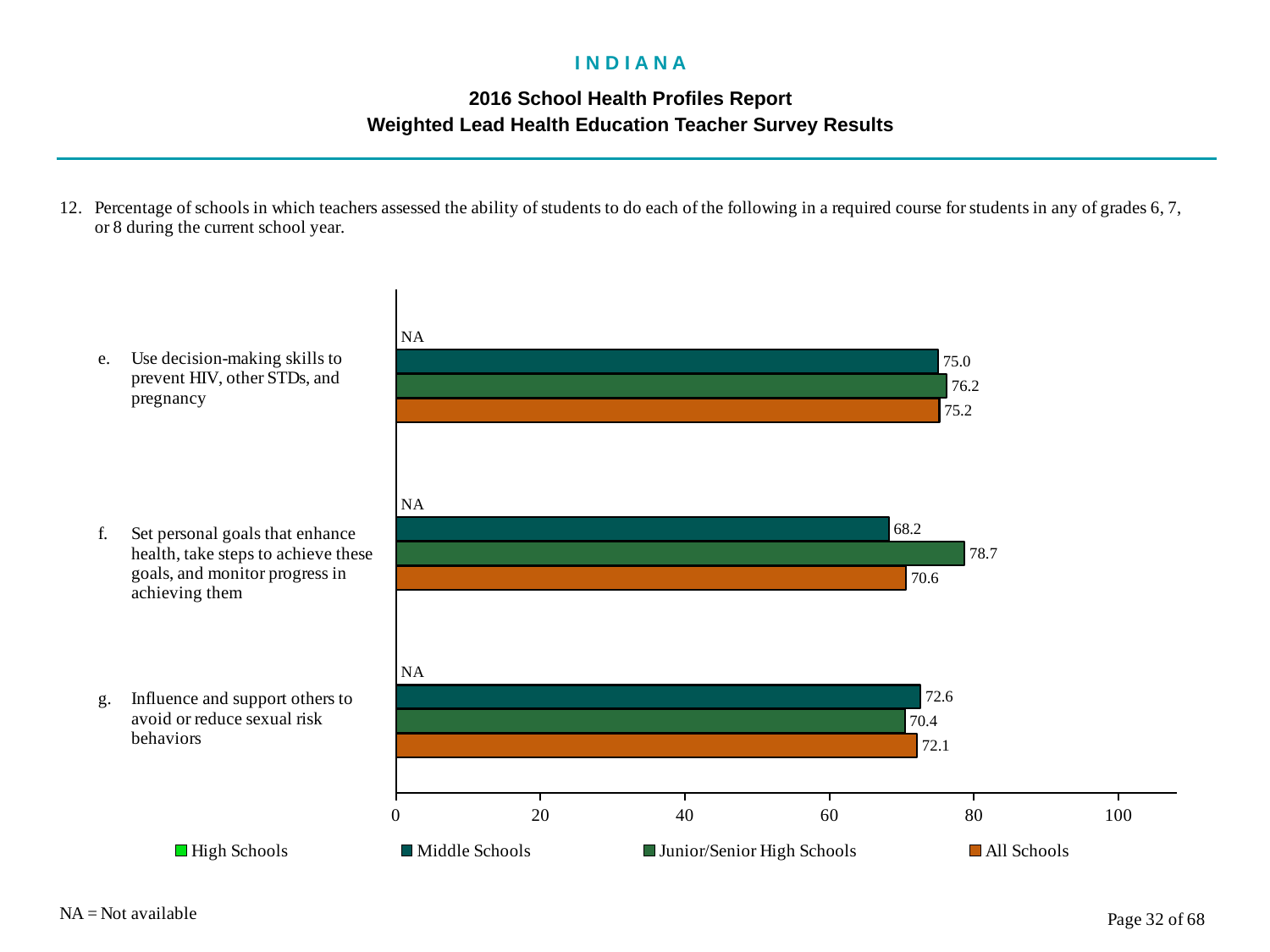
Which series has the highest value for 'Set personal goals that enhance health, take steps to achieve these goals, and monitor progress in achieving them'? Junior/Senior High Schools What is the value for All Schools for 'Influence and support others to avoid or reduce sexual risk behaviors'? 72.1 Is the All Schools value for 'Set personal goals that enhance health, take steps to achieve these goals, and monitor progress in achieving them' greater or less than 80? less What value is shown for High Schools for 'Set personal goals that enhance health, take steps to achieve these goals, and monitor progress in achieving them'? NA What does NA stand for according to the note on the slide? Not available Which series has the lowest value for 'Influence and support others to avoid or reduce sexual risk behaviors'? Junior/Senior High Schools What is the value for Middle Schools for 'Use decision-making skills to prevent HIV, other STDs, and pregnancy'? 75.0 What kind of chart is shown on the slide? bar chart What is the difference between the Junior/Senior High Schools and Middle Schools values for 'Set personal goals that enhance health, take steps to achieve these goals, and monitor progress in achieving them'? 10.5 How many series does the legend list? 4 What is the value for Junior/Senior High Schools for 'Set personal goals that enhance health, take steps to achieve these goals, and monitor progress in achieving them'? 78.7 Which is larger for 'Influence and support others to avoid or reduce sexual risk behaviors': Middle Schools or All Schools? Middle Schools